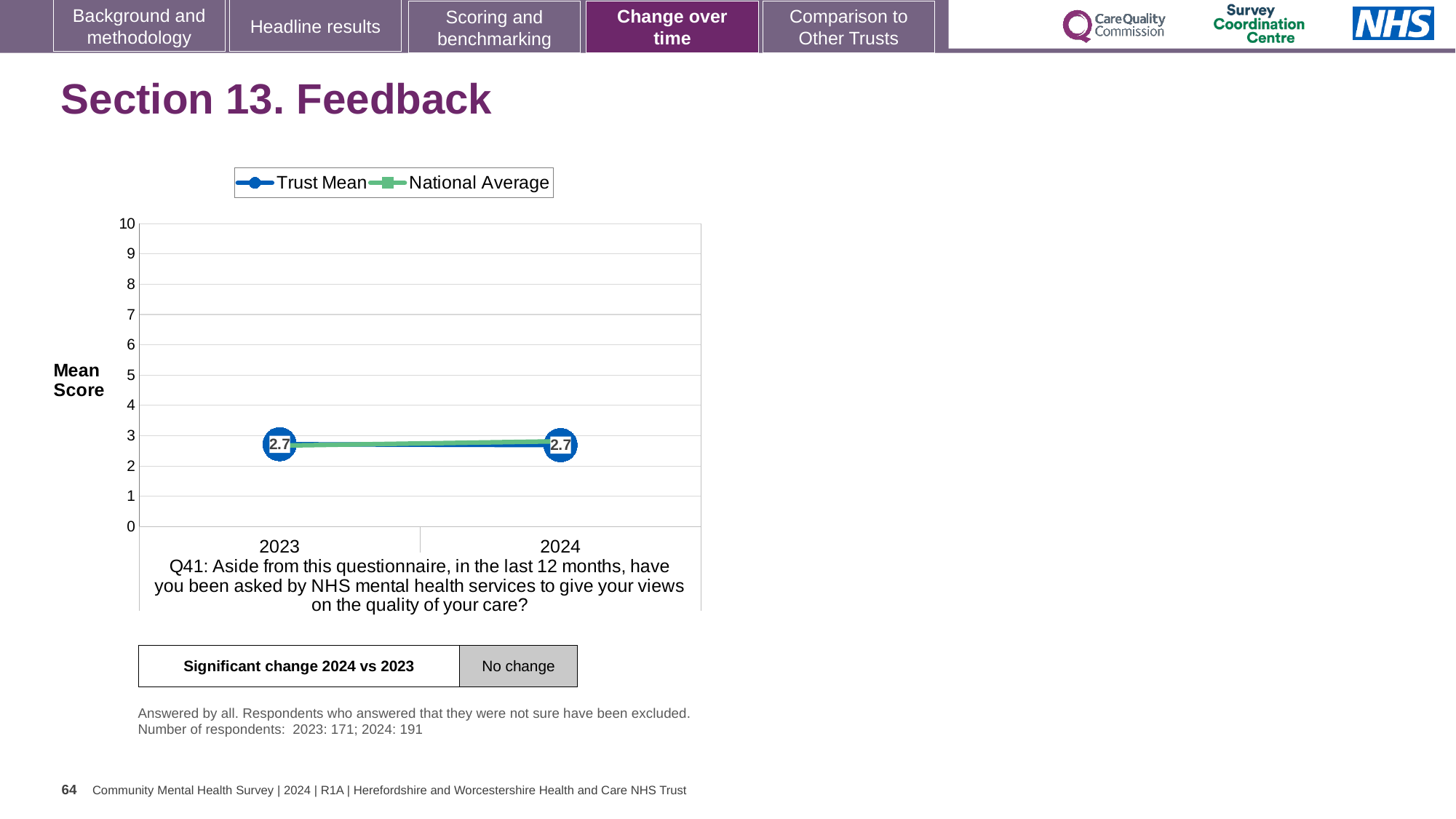
Does the Trust Mean rise, fall or stay the same from 2023 to 2024? stays the same Is the National Average value for 2024 greater or less than 5? less What is the difference between the Trust Mean in 2024 and the Trust Mean in 2023? 0 What is the Trust Mean value for 2023? 2.7 How many series does the legend list? 2 Which series is shown in blue in the legend? Trust Mean Is the Trust Mean value for 2023 greater or less than 2? greater What is the label on the y axis of the chart? Mean Score What is the Trust Mean value for 2024? 2.7 How many years are plotted on the x axis? 2 What kind of chart is shown on the slide? line chart